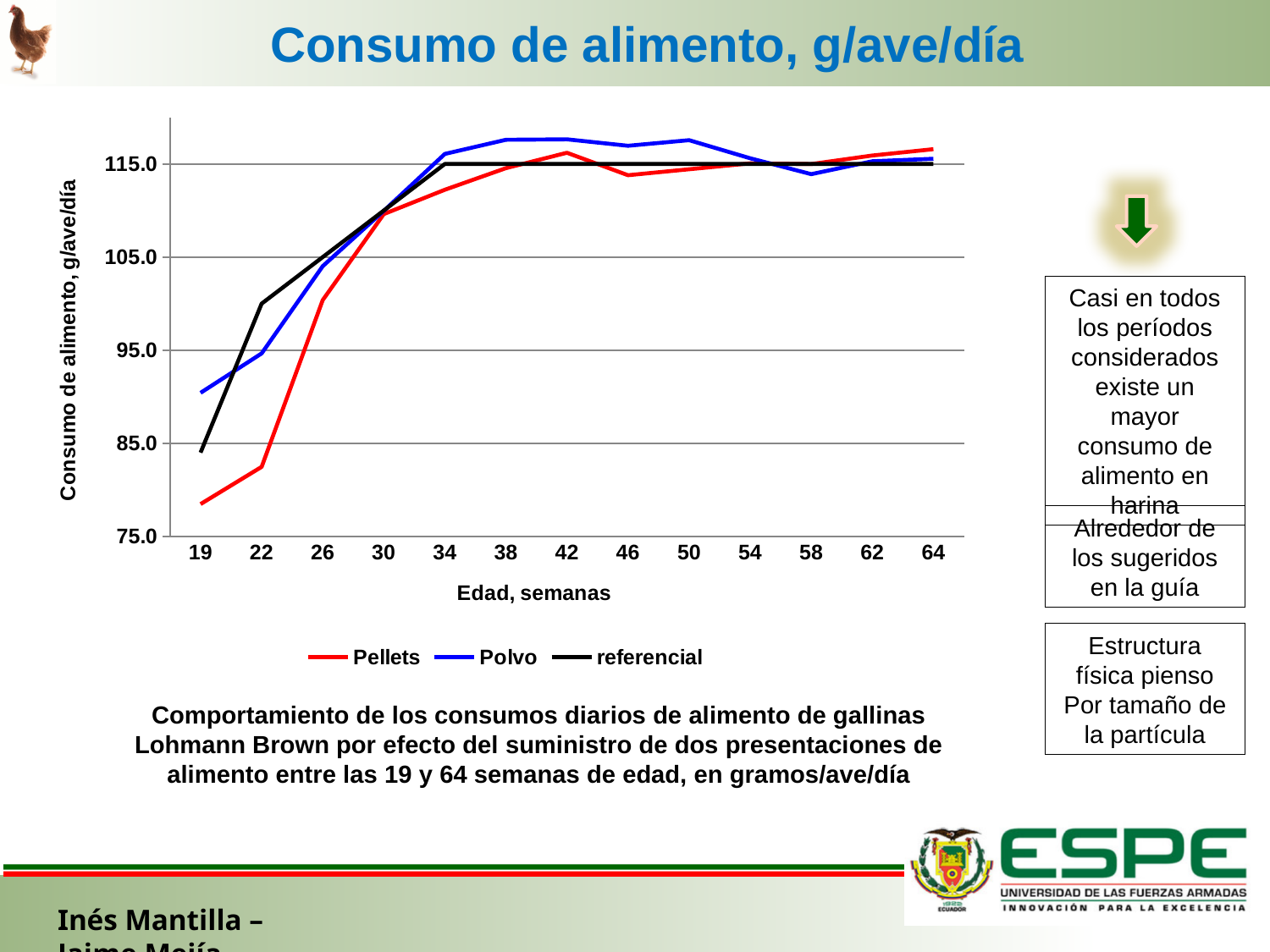
Is the value for Polvo at week 38 greater or less than 115? greater At week 22, which series has the larger value, Pellets or referencial? referencial What is the value of the referencial series at week 50? 115.0 What kind of chart is shown on the slide? line chart Is the value for Pellets at week 19 greater or less than 85? less At which week does the Pellets series reach its lowest value? 19 Does the Pellets series rise or fall between week 19 and week 34? rise Is the value for referencial at week 22 greater or less than 95? greater How many age points (weeks) are plotted along the x axis? 13 How many series does the chart legend list? 3 At week 19, which series has the larger value, Pellets or Polvo? Polvo